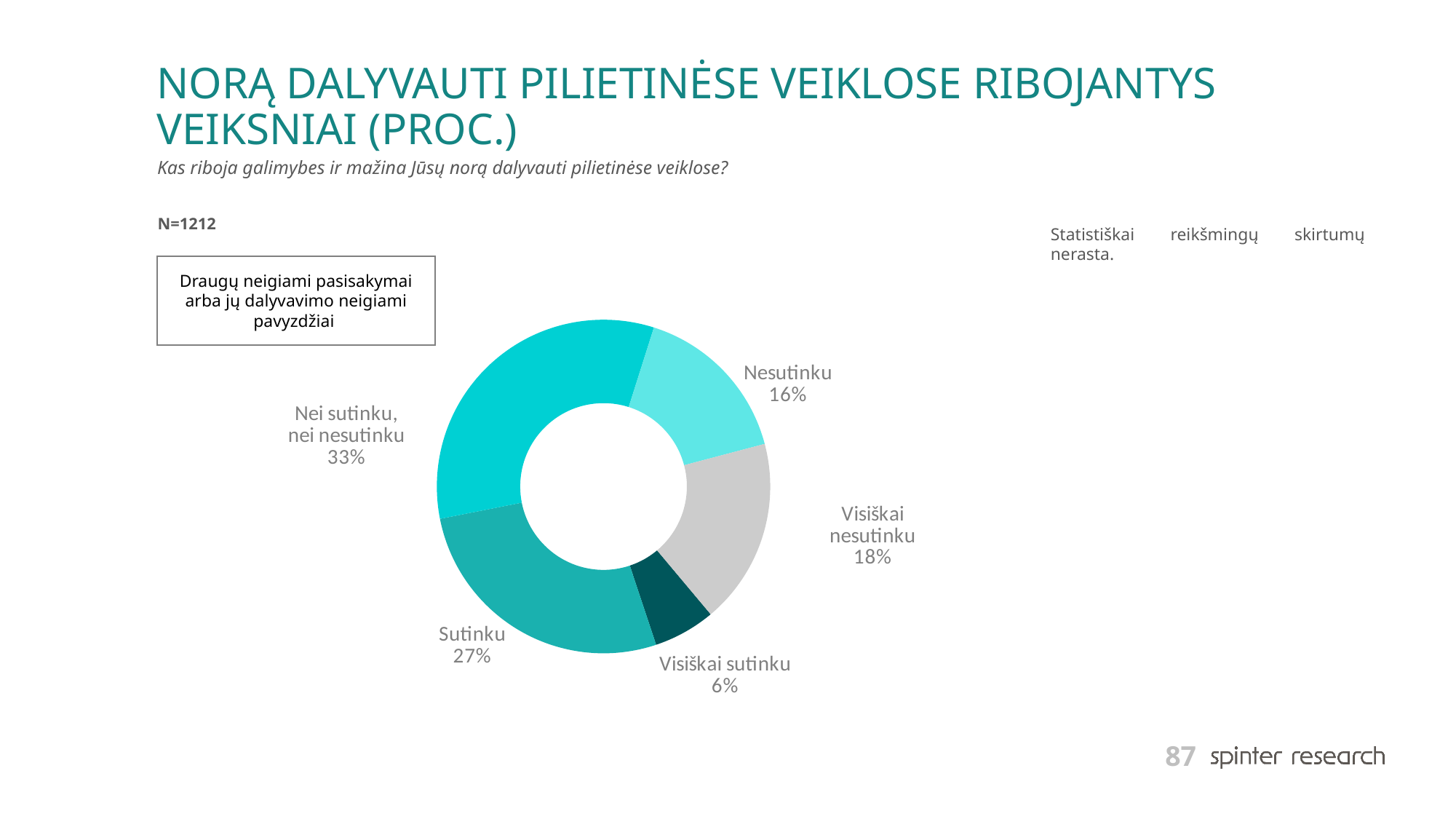
How many categories are shown in the pie chart? 5 What is the sample size (N) stated on the slide? N=1212 Which is larger, the share for "Visiškai nesutinku" or the share for "Nesutinku"? Visiškai nesutinku What is the difference in percentage points between "Sutinku" and "Nesutinku"? 11 What type of chart is shown on the slide? Pie chart (doughnut) What is the value shown for "Visiškai nesutinku"? 18% Which category has the smallest share of the pie? Visiškai sutinku What percentage of respondents answered "Nei sutinku, nei nesutinku"? 33% What share of the pie is labelled "Sutinku"? 27% What is the value shown for "Visiškai sutinku"? 6% Which category has the largest share of the pie? Nei sutinku, nei nesutinku What is the value shown for "Nesutinku"? 16%